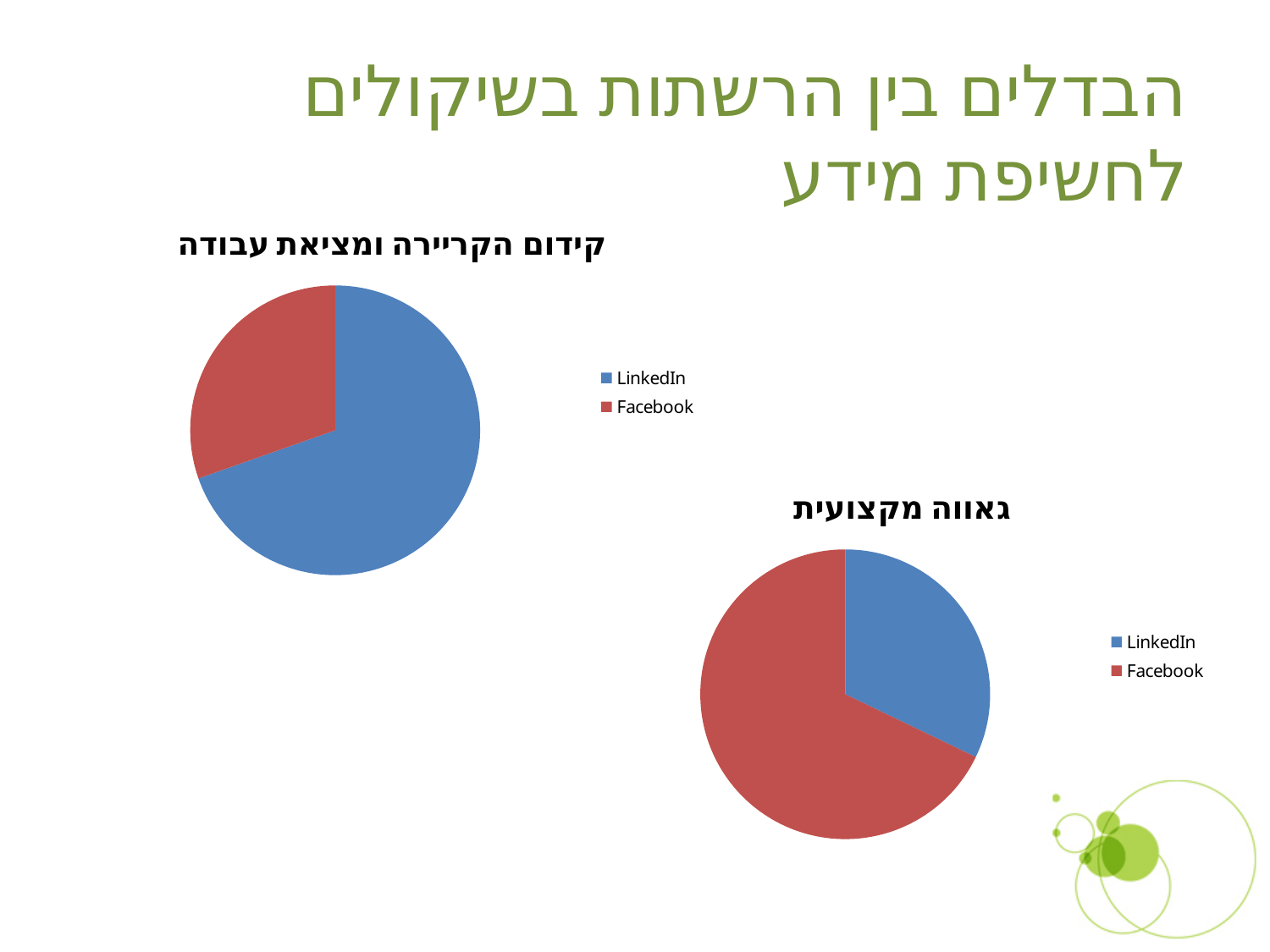
How many entries does the legend of the chart titled "גאווה מקצועית" list? 2 How many slices does the chart titled "קידום הקריירה ומציאת עבודה" have? 2 In the chart titled "קידום הקריירה ומציאת עבודה", which network has the smallest slice? Facebook In the chart titled "גאווה מקצועית", which network has the smallest slice? LinkedIn In the chart titled "קידום הקריירה ומציאת עבודה", is the slice for LinkedIn or Facebook larger? LinkedIn In the chart titled "גאווה מקצועית", is the slice for LinkedIn or Facebook larger? Facebook In the chart titled "גאווה מקצועית", which colour represents Facebook? red In the chart titled "גאווה מקצועית", which network has the largest slice? Facebook What kind of chart is the chart titled "קידום הקריירה ומציאת עבודה"? pie chart What kind of chart is the chart titled "גאווה מקצועית"? pie chart How many pie charts are shown on the slide? 2 In the chart titled "קידום הקריירה ומציאת עבודה", which network has the largest slice? LinkedIn